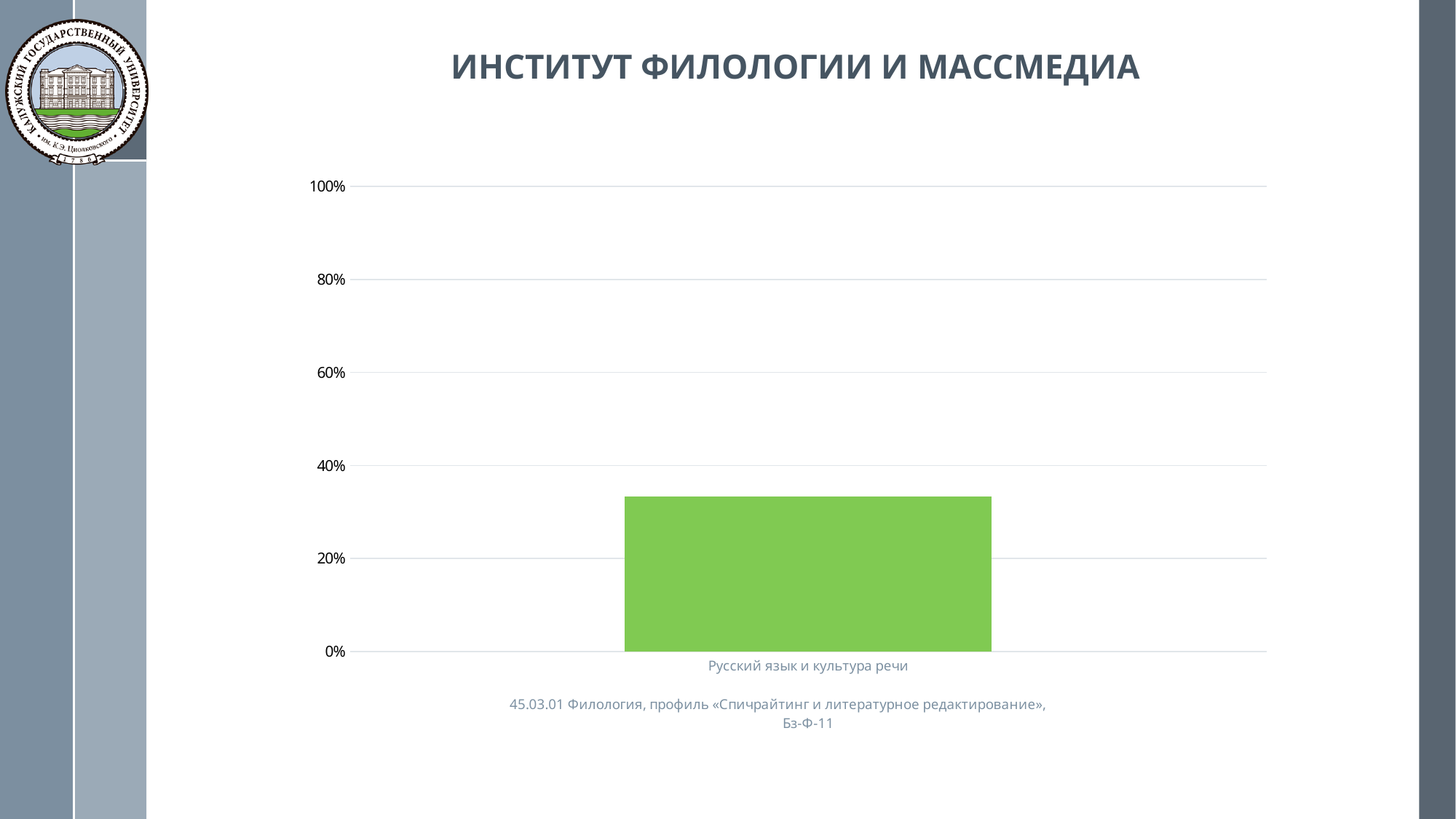
What kind of chart is shown on the slide? bar chart Is the value for Русский язык и культура речи greater or less than 40%? less Is the value for Русский язык и культура речи greater or less than 60%? less What is the highest value shown on the vertical axis of the chart? 100% What is the lowest value shown on the vertical axis of the chart? 0% What is the label of the single category plotted in the chart? Русский язык и культура речи How many bars are plotted in the chart? 1 What colour is the bar in the chart? green Is the value for Русский язык и культура речи greater or less than 20%? greater